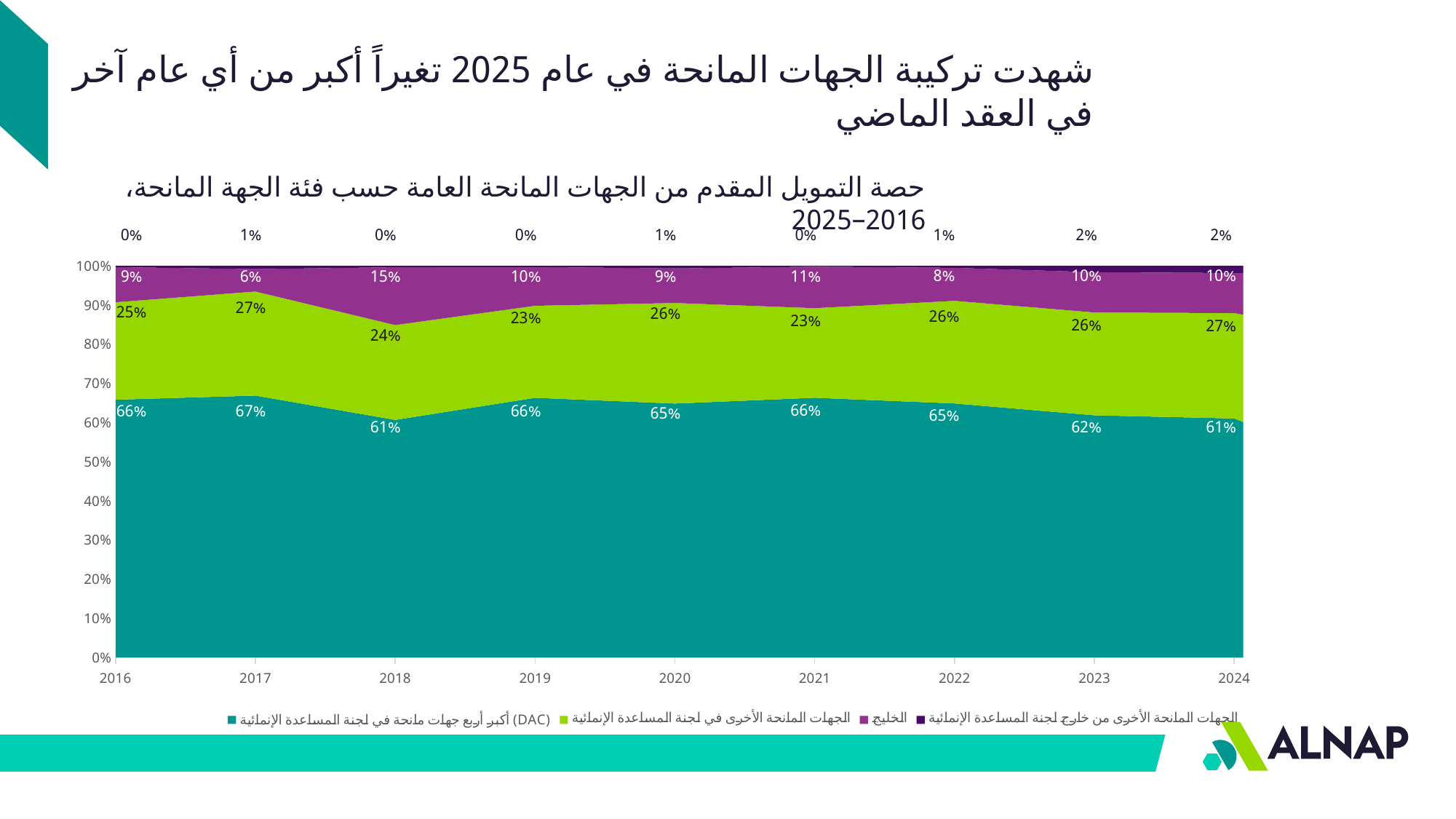
What type of chart is shown on the slide? Stacked area chart What is the value for the series 'الجهات المانحة الأخرى في لجنة المساعدة الإنمائية' in 2024? 27% What is the difference between the 2017 and 2024 values for the series 'أكبر أربع جهات مانحة في لجنة المساعدة الإنمائية (DAC)'? 6% In which year is the value for the series 'أكبر أربع جهات مانحة في لجنة المساعدة الإنمائية (DAC)' highest? 2017 In which year is the value for the series 'الخليج' lowest? 2017 What years does the chart subtitle say the data covers? 2016–2025 What is the value for the series 'الجهات المانحة الأخرى من خارج لجنة المساعدة الإنمائية' in 2023? 2% What is the value for the series 'الخليج' in 2018? 15% How many series does the chart legend list? 4 Which is larger: the value for 'الخليج' in 2021 or in 2022? 2021 What is the value for the series 'أكبر أربع جهات مانحة في لجنة المساعدة الإنمائية (DAC)' in 2018? 61% How many years are plotted along the x axis of the chart? 9